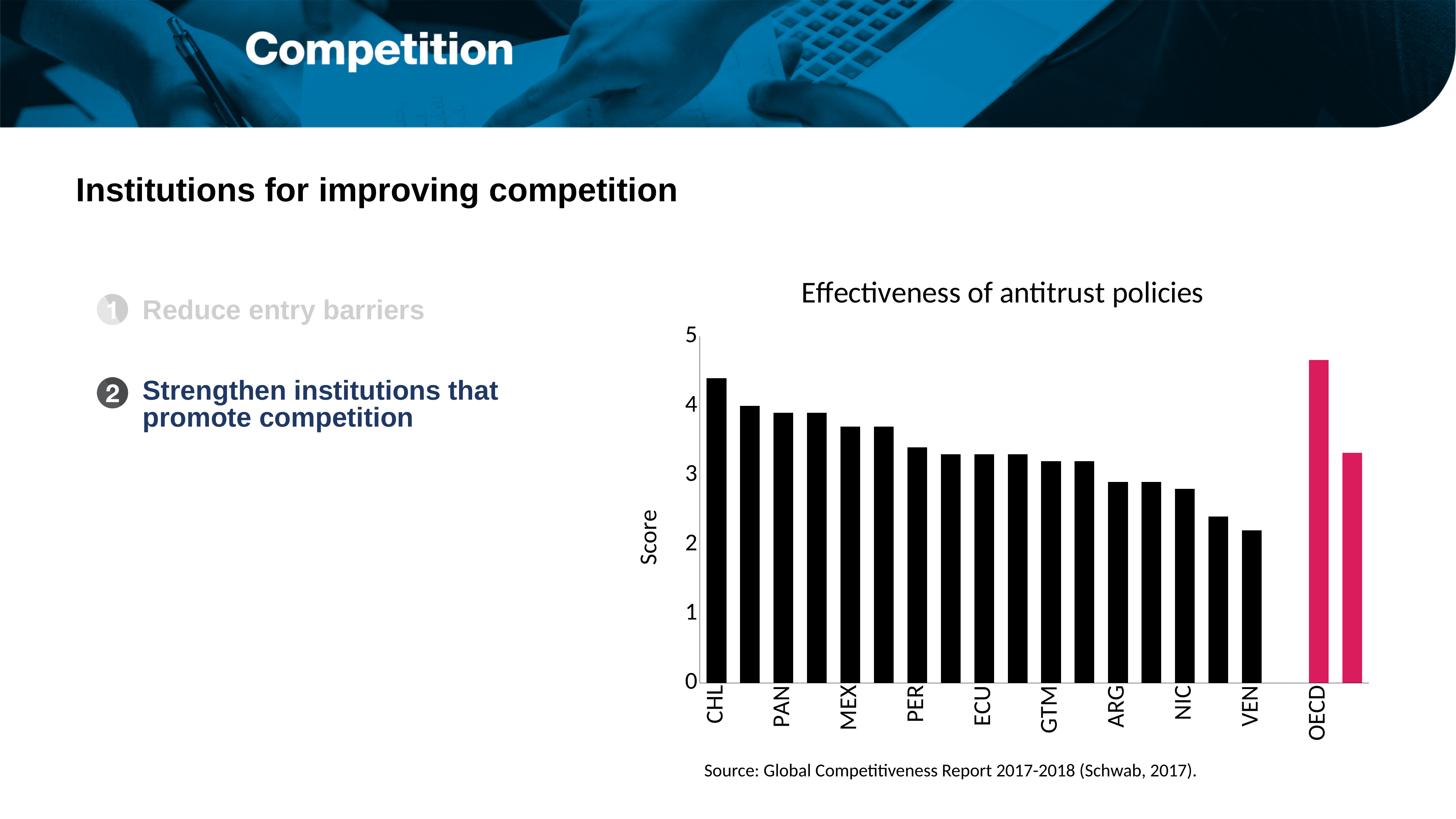
What is the title of the chart? Effectiveness of antitrust policies Is the score for VEN greater or less than 3? less Is the score for MEX greater or less than 3? greater Which labelled country has the lowest score in the chart? VEN Do the scores for the countries rise or fall from left to right along the x axis? fall Is the score for CHL greater or less than 4? greater What is the label on the vertical axis of the chart? Score Which bar in the chart is the highest? OECD Which has a higher score, CHL or VEN? CHL What kind of chart is shown on the slide? bar chart Which has a higher score, OECD or CHL? OECD